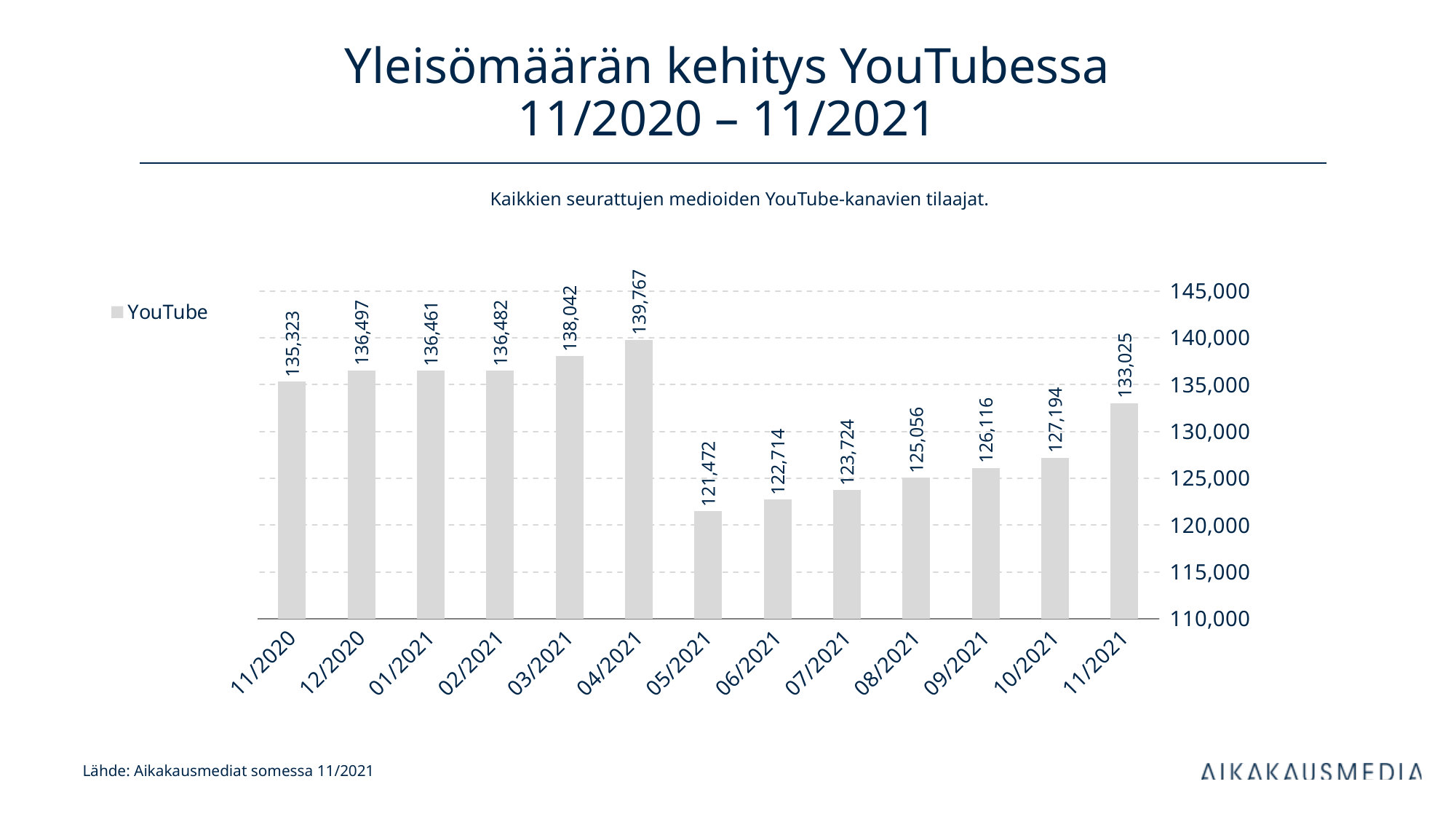
What is the value for 05/2021? 121,472 How many months are shown on the x axis? 13 Which is larger, the value for 03/2021 or the value for 10/2021? 03/2021 What is the difference between the values for 11/2020 and 11/2021? 2,298 What is the value for 04/2021? 139,767 Which month has the highest value? 04/2021 What is the value for 11/2020? 135,323 Is the value for 11/2021 greater or less than 130,000? greater What is the difference between the values for 04/2021 and 05/2021? 18,295 What kind of chart is shown on the slide? bar chart How many series does the legend list? 1 Which month has the lowest value? 05/2021